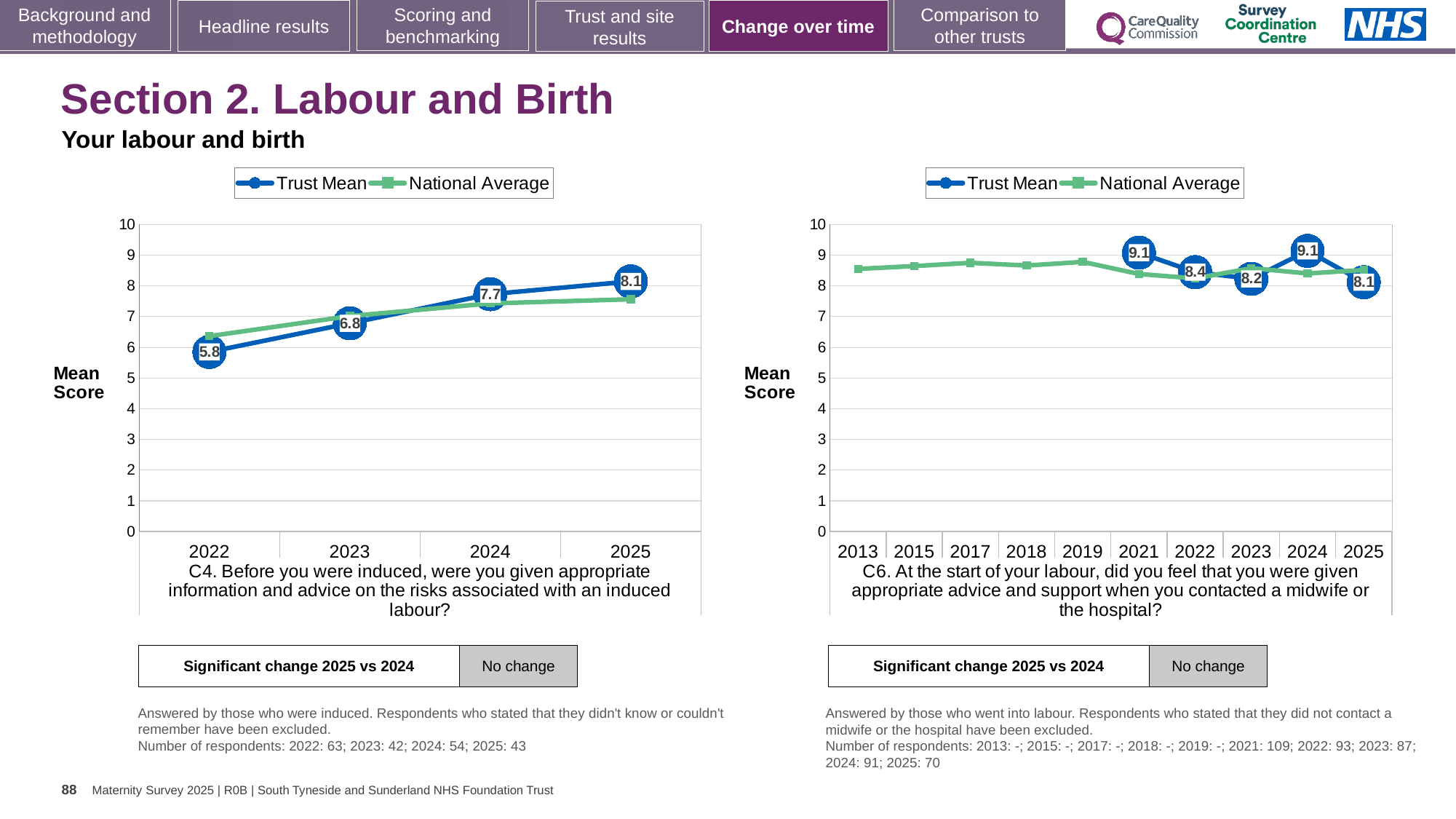
In the left chart (C4), what is the difference between the Trust Mean scores for 2025 and 2022? 2.3 In the left chart (C4), how many years are shown on the x axis? 4 What type of chart is the left chart (C4)? line chart In the right chart (C6), what is the Trust Mean score for 2023? 8.2 In the right chart (C6), which is larger, the Trust Mean for 2024 or the Trust Mean for 2025? 2024 In the left chart (C4), what is the Trust Mean score for 2022? 5.8 In the left chart (C4), does the Trust Mean rise or fall from 2022 to 2025? rise In the right chart (C6), how many series does the legend list? 2 In the left chart (C4), which year has the lowest Trust Mean score? 2022 In the right chart (C6), is the National Average for 2019 greater or less than 8? greater In the right chart (C6), what is the Trust Mean score for 2022? 8.4 In the left chart (C4), what is the Trust Mean score for 2025? 8.1